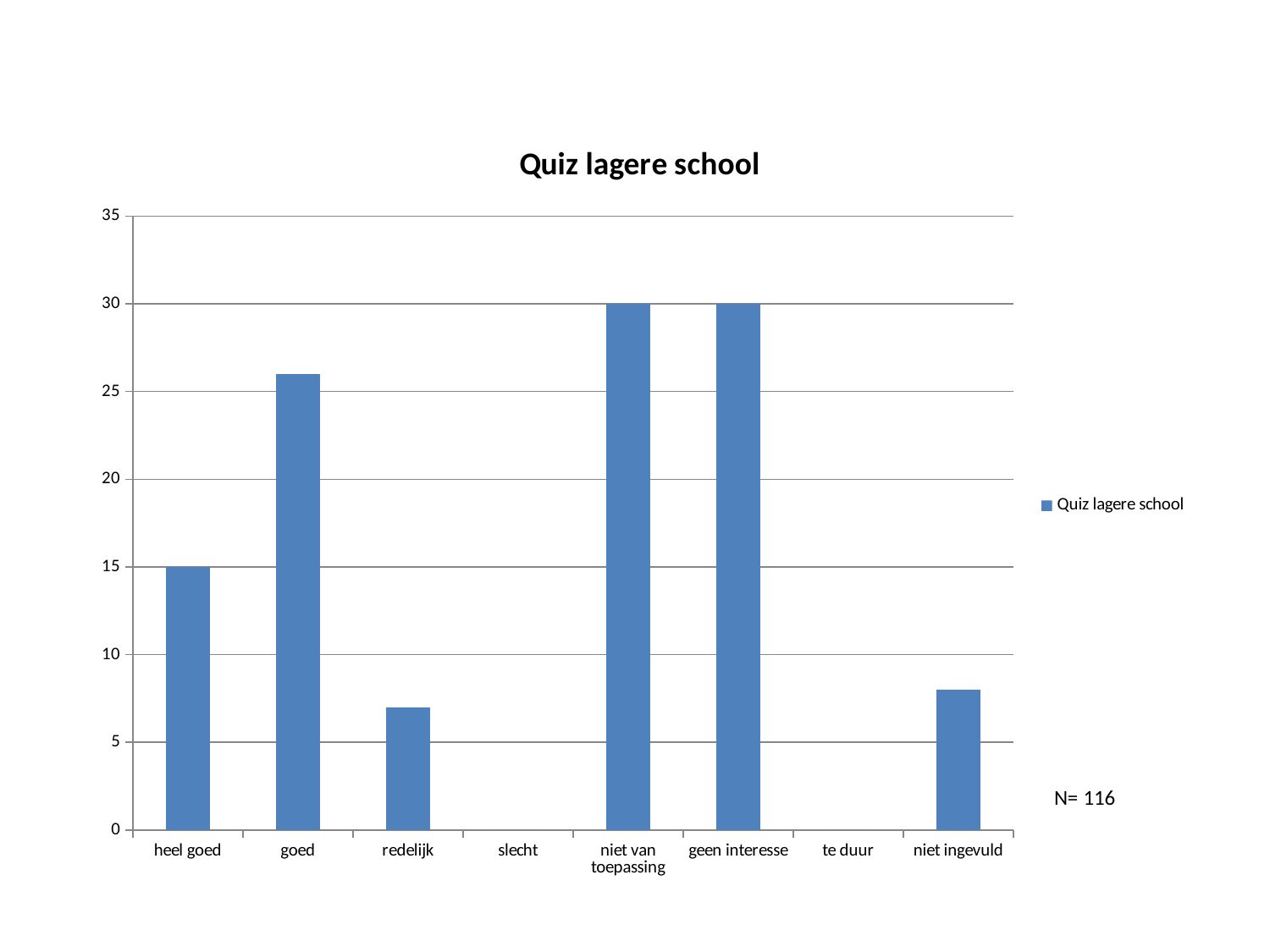
What is the value for geen interesse? 30 How many categories are shown on the x axis? 8 Is the value for goed greater or less than 25? greater What is the difference between the value for niet van toepassing and the value for heel goed? 15 What kind of chart is shown on the slide? bar chart How many series does the legend list? 1 What is the value for heel goed? 15 Is the value for niet ingevuld greater or less than 10? less What is the value for niet van toepassing? 30 Which is larger, the value for goed or the value for heel goed? goed Which is larger, the value for niet van toepassing or the value for redelijk? niet van toepassing Is the value for redelijk greater or less than 10? less